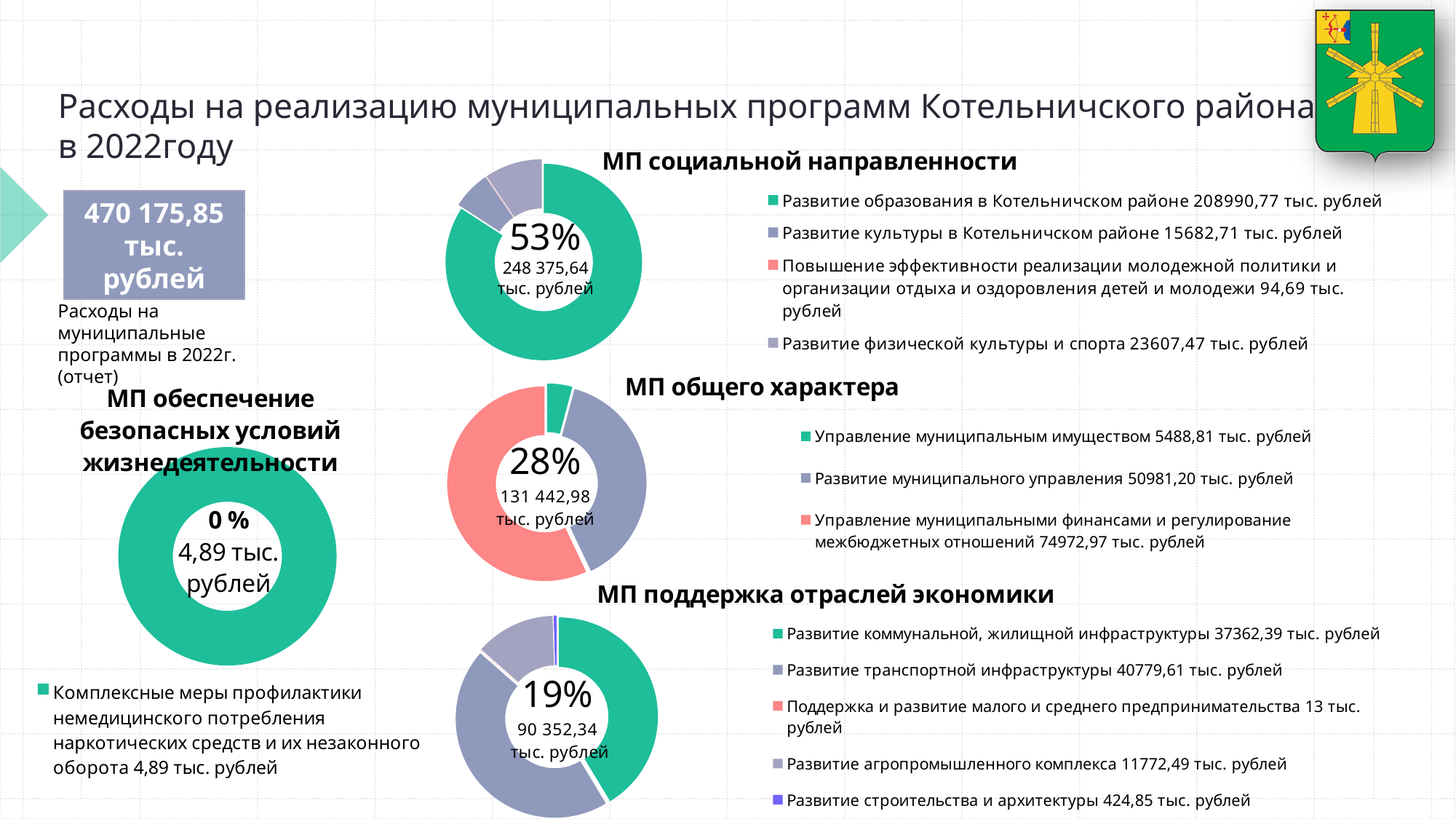
In the 'МП поддержка отраслей экономики' chart, what is the difference between 'Развитие транспортной инфраструктуры' and 'Развитие коммунальной, жилищной инфраструктуры'? 3417,22 тыс. рублей How many categories does the legend of the 'МП поддержка отраслей экономики' chart list? 5 How many categories does the legend of the 'МП социальной направленности' chart list? 4 In the 'МП общего характера' chart, what is the difference between 'Управление муниципальными финансами и регулирование межбюджетных отношений' and 'Развитие муниципального управления'? 23991,77 тыс. рублей In the 'МП общего характера' chart, which category has the highest value? Управление муниципальными финансами и регулирование межбюджетных отношений In the 'МП социальной направленности' chart, which category has the lowest value? Повышение эффективности реализации молодежной политики и организации отдыха и оздоровления детей и молодежи What kind of chart is used for 'МП социальной направленности'? Donut (pie) chart What percentage is shown in the centre of the 'МП общего характера' chart? 28% In the 'МП социальной направленности' chart, what is the value for 'Развитие образования в Котельничском районе'? 208990,77 тыс. рублей What is the total amount shown in the centre of the 'МП поддержка отраслей экономики' chart? 90 352,34 тыс. рублей What total amount is shown in the centre of the 'МП обеспечение безопасных условий жизнедеятельности' chart? 4,89 тыс. рублей In the 'МП поддержка отраслей экономики' chart, which is larger: 'Развитие транспортной инфраструктуры' or 'Развитие коммунальной, жилищной инфраструктуры'? Развитие транспортной инфраструктуры